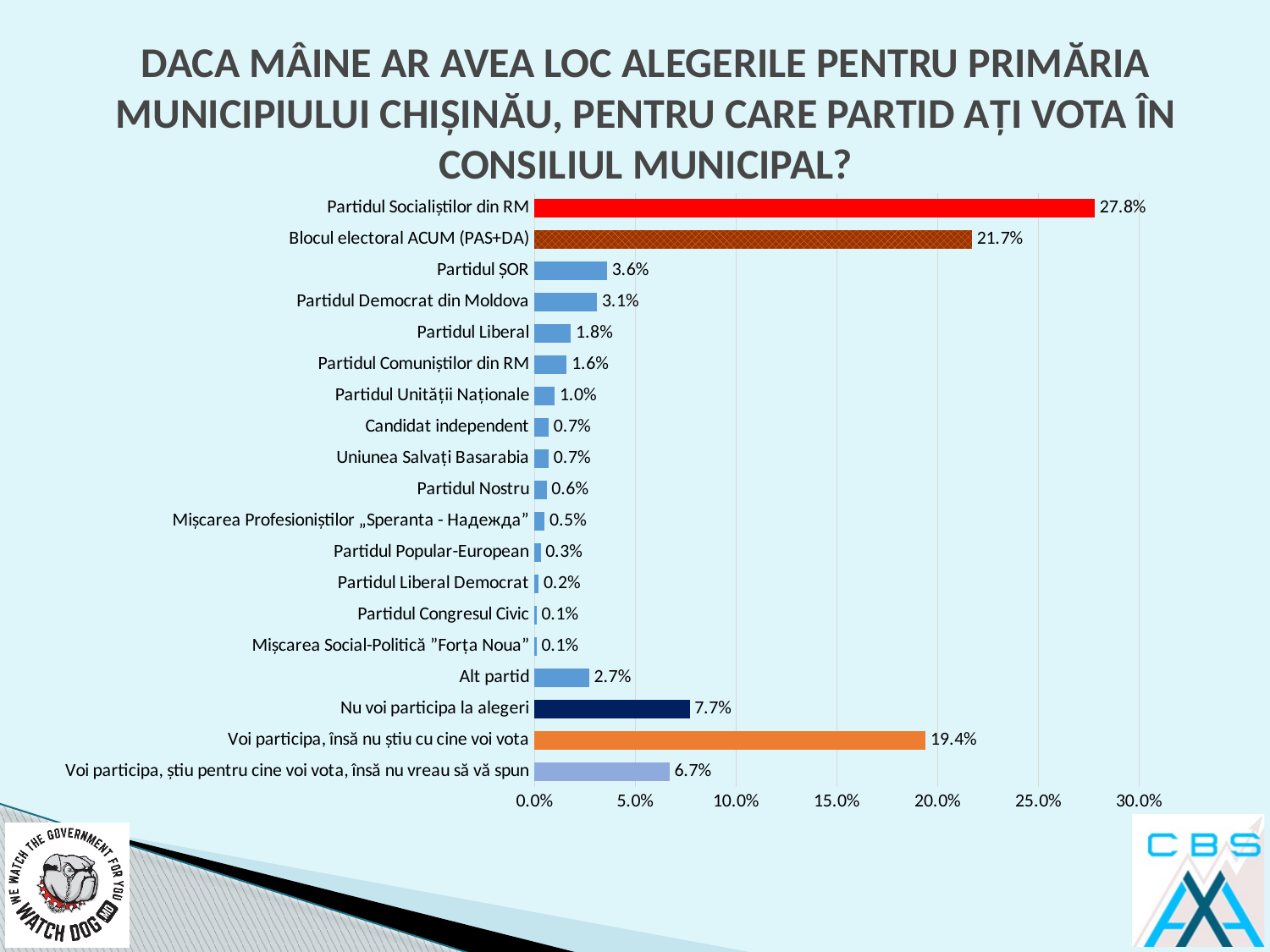
What percentage is shown for 'Voi participa, însă nu știu cu cine voi vota'? 19.4% What percentage is shown for Blocul electoral ACUM (PAS+DA)? 21.7% What is the value shown for Alt partid? 2.7% How many categories are plotted on the chart? 19 What percentage is shown for Partidul Socialiștilor din RM? 27.8% What kind of chart is shown on the slide? bar chart Which has a larger value, Partidul ȘOR or Partidul Democrat din Moldova? Partidul ȘOR What is the highest value shown on the x axis? 30.0% Which category has the highest value on the chart? Partidul Socialiștilor din RM Is the value for Blocul electoral ACUM (PAS+DA) greater or less than 20.0%? greater What is the difference between the values for Partidul Socialiștilor din RM and Blocul electoral ACUM (PAS+DA)? 6.1% What percentage is shown for 'Nu voi participa la alegeri'? 7.7%